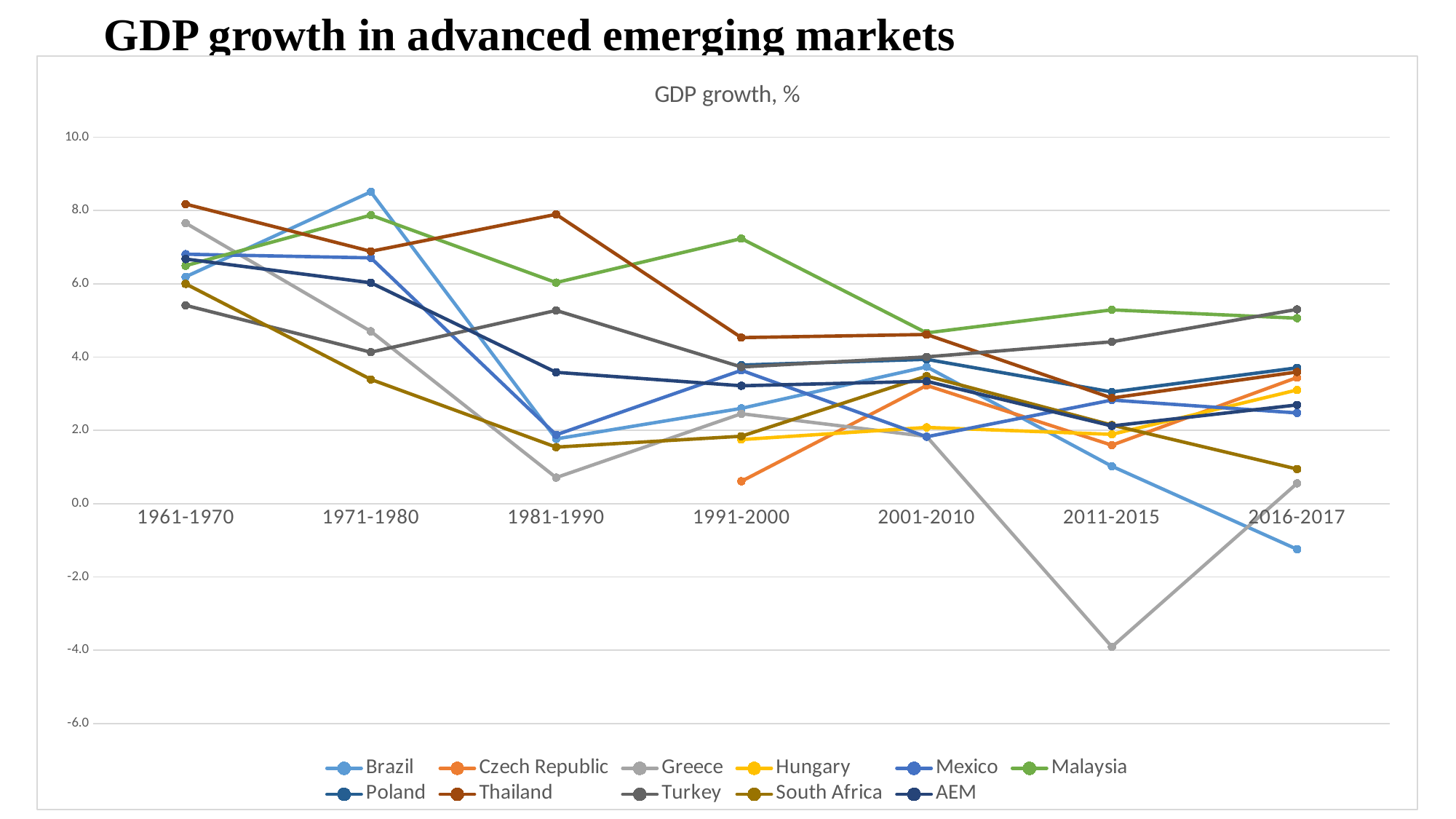
Which series has the lowest value in 2011-2015? Greece Is the value for Greece in 2011-2015 greater or less than -2.0? less What kind of chart is shown on the slide? line chart Which series has the lowest value in 2016-2017? Brazil Is the value for Brazil in 1971-1980 greater or less than 8.0? greater What is the title shown above the plot area? GDP growth, % How many series does the legend list? 11 Does the Thailand line rise or fall from 1961-1970 to 2011-2015? fall Which series has the highest value in 2011-2015? Malaysia Which series has the highest value in 1971-1980? Brazil Is the value for Brazil in 2016-2017 greater or less than 0.0? less How many time periods are shown on the x axis? 7